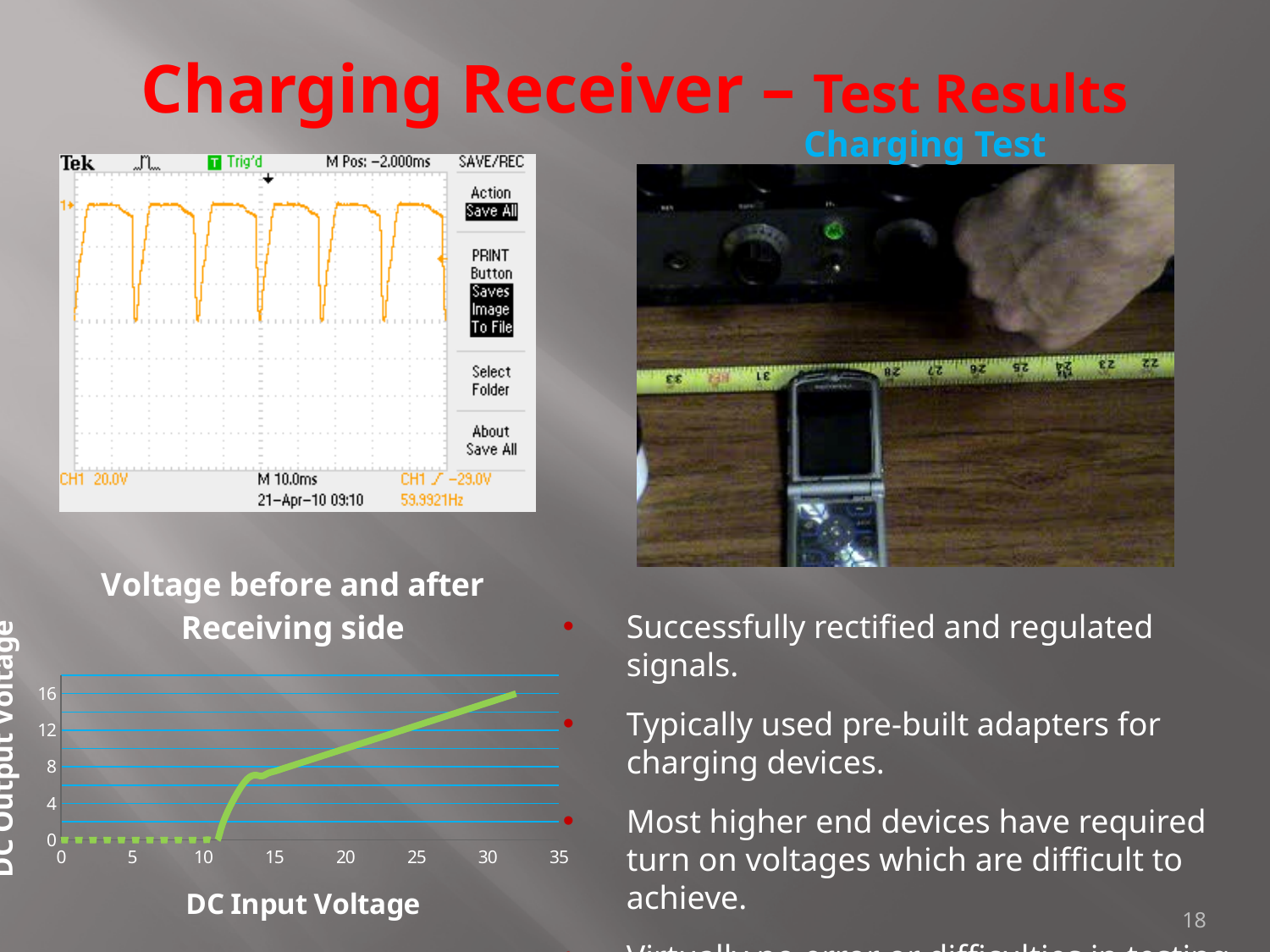
In the "Voltage before and after Receiving side" chart, is the DC output voltage at a DC input voltage of 15 greater or less than 4? greater What kind of chart is the "Voltage before and after Receiving side" chart? line chart In the "Voltage before and after Receiving side" chart, which has the larger DC output voltage: a DC input voltage of 15 or of 25? 25 In the "Voltage before and after Receiving side" chart, is the DC output voltage at a DC input voltage of 20 greater or less than 8? greater What is the y-axis title of the line chart on the slide? DC Output Voltage In the "Voltage before and after Receiving side" chart, is the DC output voltage at a DC input voltage of 5 greater or less than 4? less In the "Voltage before and after Receiving side" chart, does the DC output voltage rise or fall as DC input voltage increases beyond about 10? rise In the "Voltage before and after Receiving side" chart, which has the larger DC output voltage: a DC input voltage of 10 or of 30? 30 What is the x-axis title of the line chart on the slide? DC Input Voltage